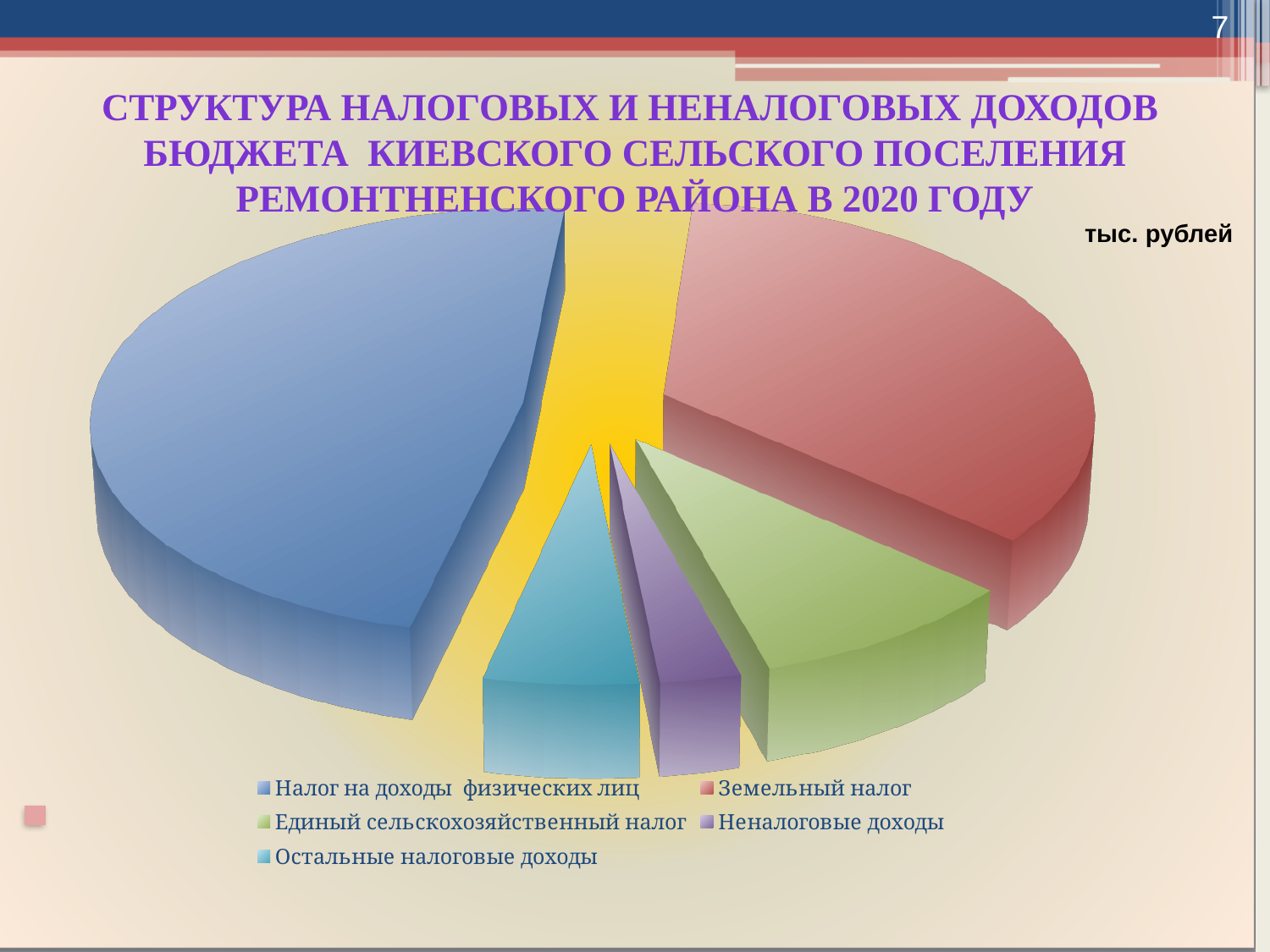
How many slices does the pie chart have? 5 Which category has the largest slice in the pie chart? Налог на доходы физических лиц How many entries does the legend of the pie chart list? 5 What colour is the slice for Земельный налог in the pie chart? red Which slice is larger: Налог на доходы физических лиц or Земельный налог? Налог на доходы физических лиц Which slice is larger: Единый сельскохозяйственный налог or Неналоговые доходы? Единый сельскохозяйственный налог Which category has the smallest slice in the pie chart? Неналоговые доходы What kind of chart is shown on the slide? pie chart In what units are the values of the chart expressed, according to the slide? тыс. рублей Which slice is larger: Остальные налоговые доходы or Неналоговые доходы? Остальные налоговые доходы